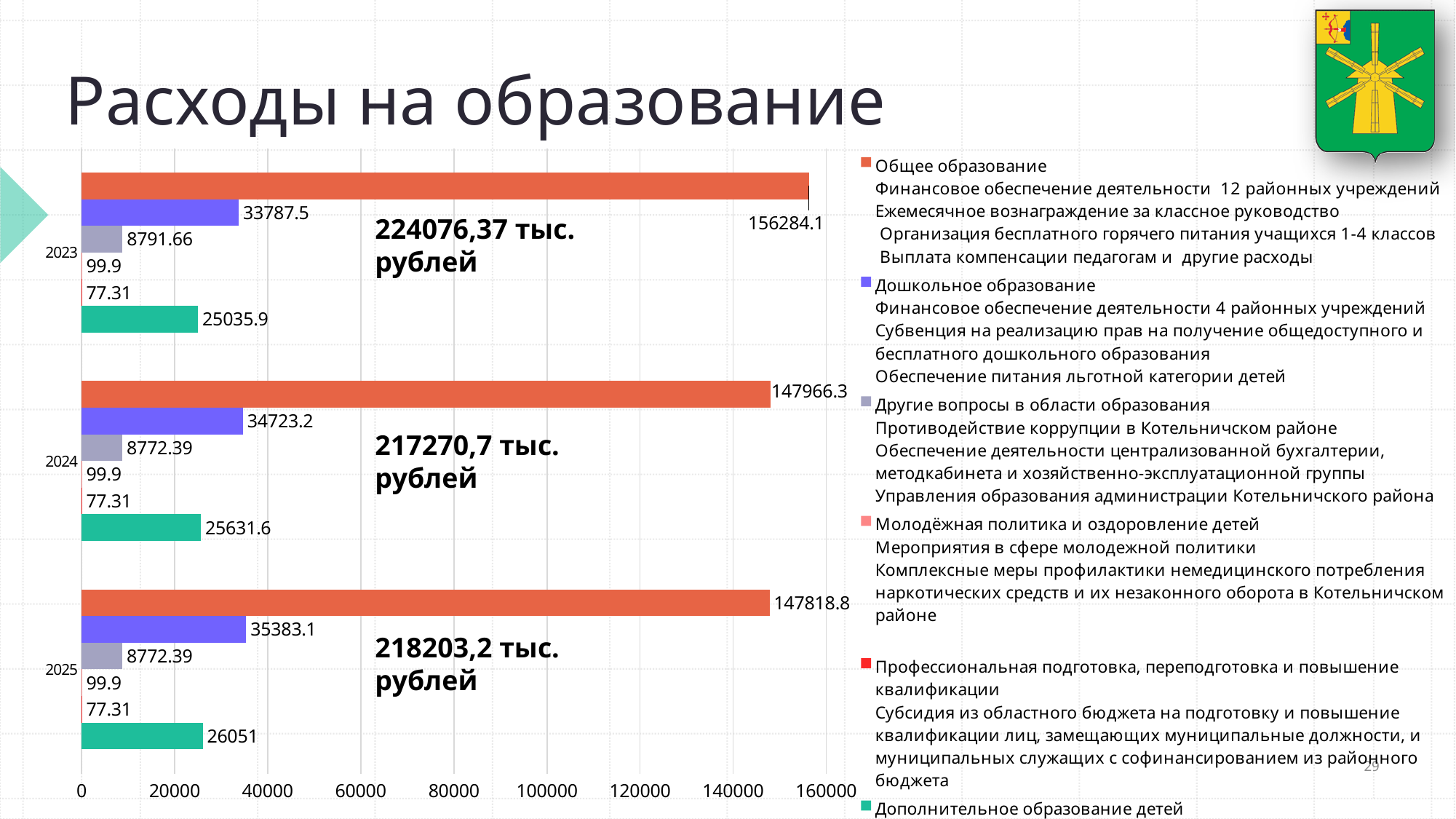
How many series does the legend list? 6 Which series has the lowest value in 2025? Профессиональная подготовка, переподготовка и повышение квалификации What is the difference between the Дошкольное образование values for 2025 and 2023? 1595.6 Is the value for Общее образование in 2024 greater or less than 140000? greater In which year is the value for Общее образование highest? 2023 What is the value for Дополнительное образование детей in 2024? 25631.6 What is the value for Дошкольное образование in 2025? 35383.1 What is the value for Общее образование in 2023? 156284.1 How many years are shown on the chart? 3 Which is larger: Дополнительное образование детей in 2025 or in 2023? 2025 What is the value for Другие вопросы в области образования in 2023? 8791.66 What kind of chart is shown on the slide? bar chart